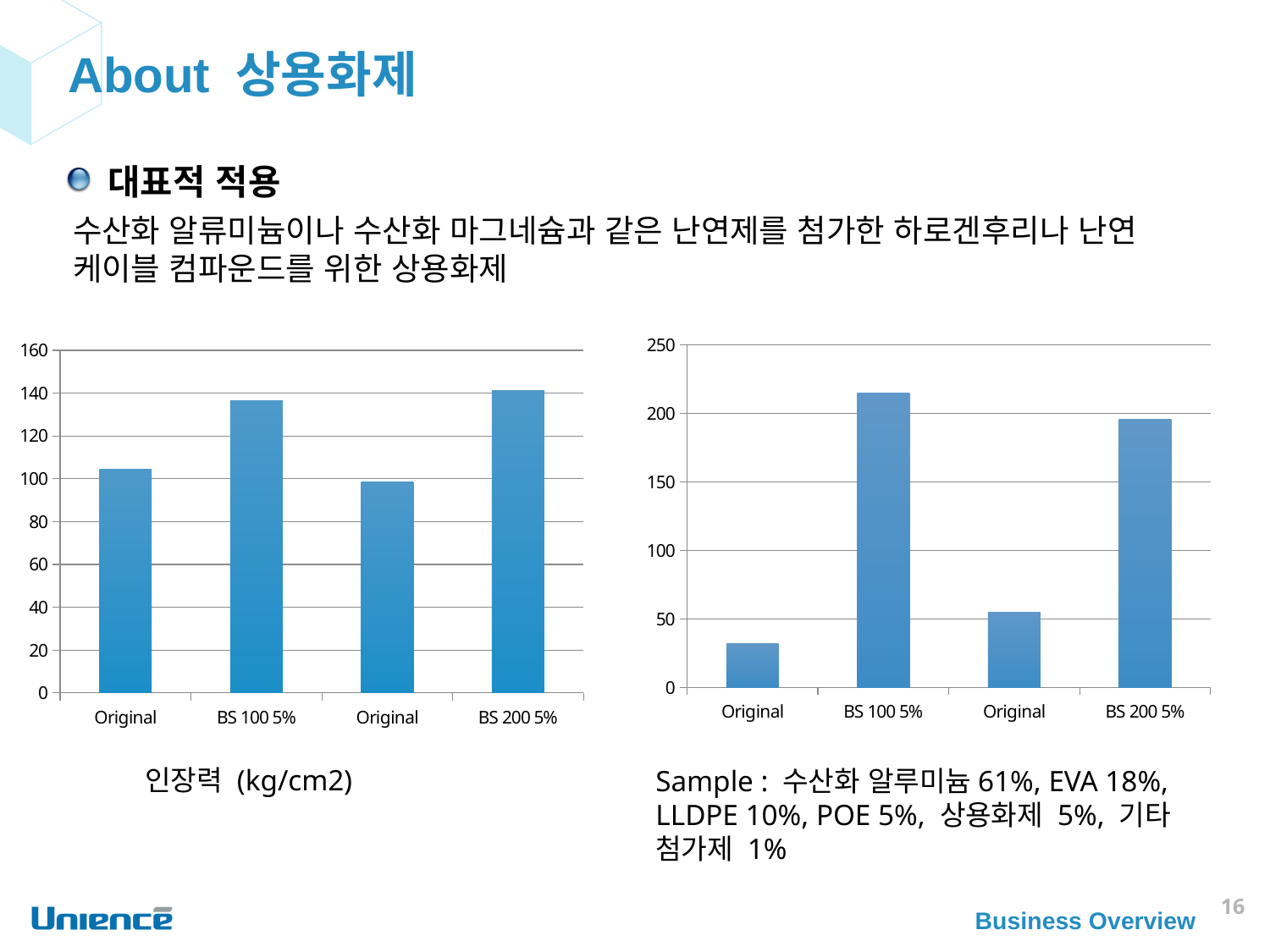
In the left chart (인장력 (kg/cm2)), is the value for the second Original bar greater or less than 120? less What is the highest value shown on the y axis of the right chart? 250 In the right chart, which is larger, BS 100 5% or BS 200 5%? BS 100 5% In the right chart, which bar has the lowest value? the first Original bar In the right chart, is the value for the first Original bar greater or less than 50? less In the right chart, is the value for BS 200 5% greater or less than 150? greater How many bars does the right chart have? 4 What kind of chart is the left chart (인장력 (kg/cm2))? bar chart In the right chart, which category has the highest value? BS 100 5% In the left chart (인장력 (kg/cm2)), which is larger, the first Original bar or BS 100 5%? BS 100 5%